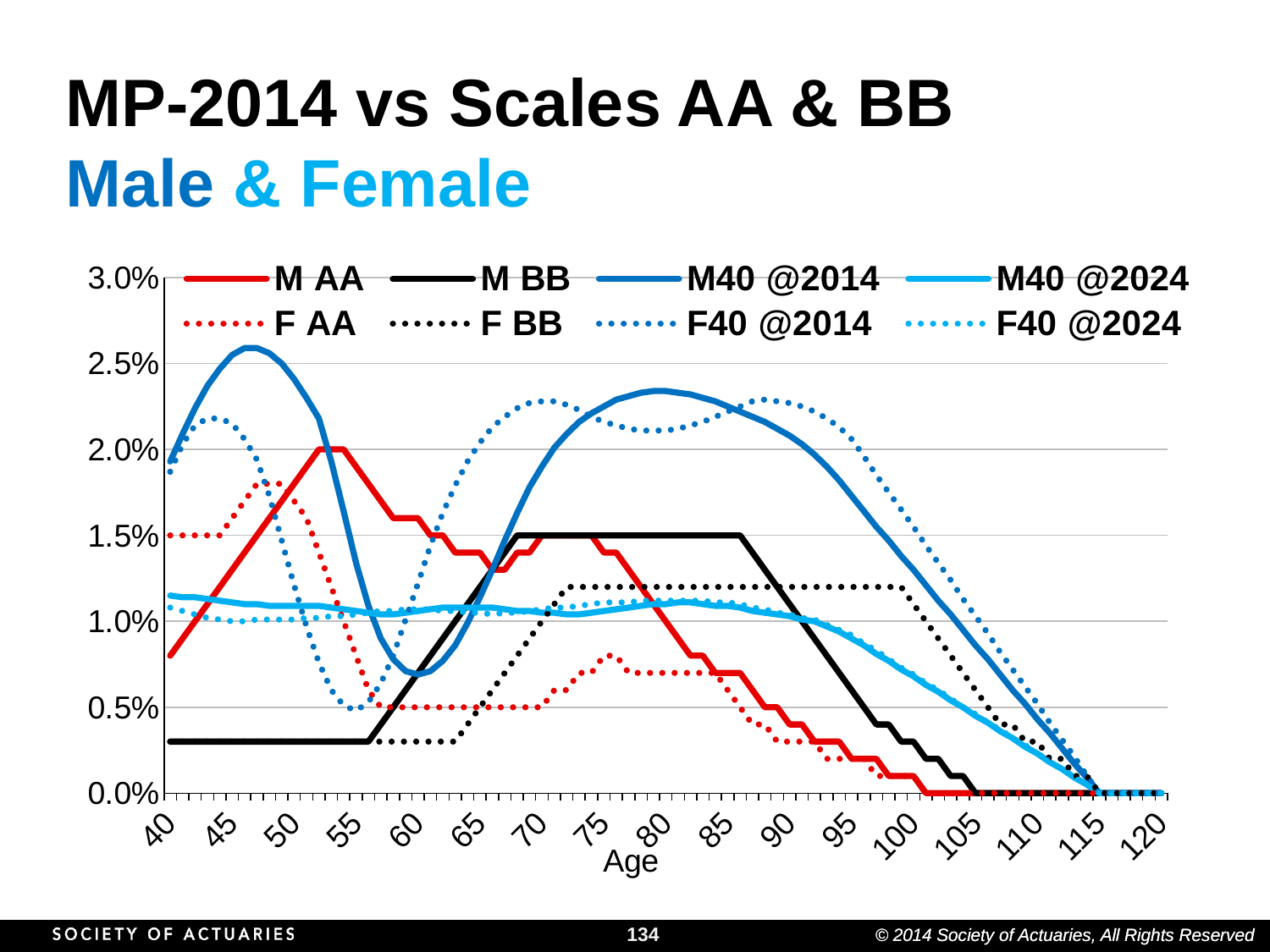
Is the value for F40 @2014 at age 90 greater or less than 2.0%? greater Is the value for M AA at age 40 greater or less than 1.0%? less Which series is drawn as a solid red line? M AA Is the value for M40 @2014 at age 45 greater or less than 2.0%? greater What kind of chart is shown on the slide? line chart Does the M40 @2024 line rise or fall between age 100 and age 115? fall Which series reaches the highest value anywhere on the chart? M40 @2014 How many series does the legend list? 8 What is the label of the x axis? Age At age 80, which is larger: M40 @2014 or M AA? M40 @2014